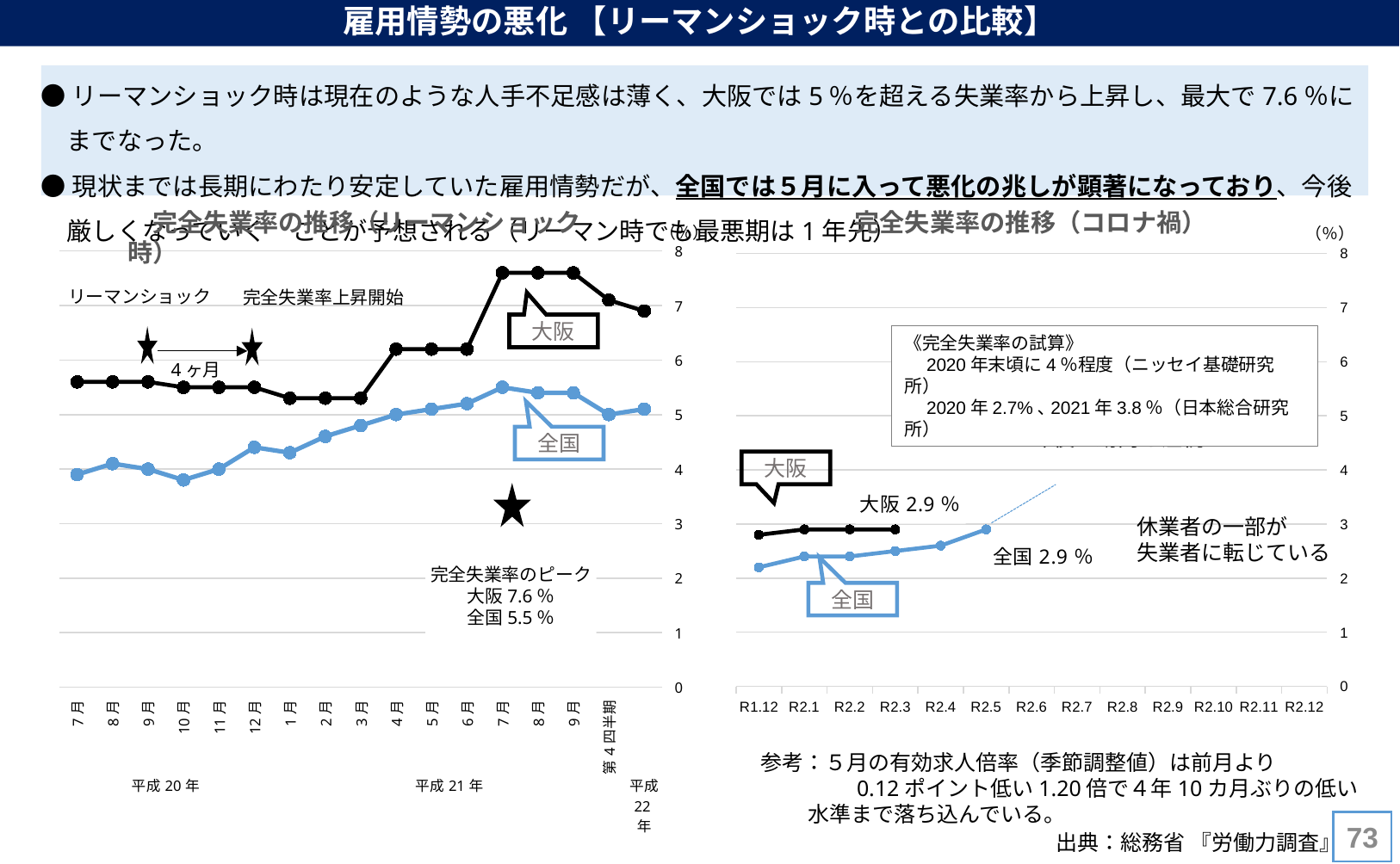
In the left chart (リーマンショック時), how many months elapsed between リーマンショック and 完全失業率上昇開始 according to the annotation? 4ヶ月 In the right chart (コロナ禍), what is the labelled value for 大阪? 2.9％ In the left chart (リーマンショック時), does the 大阪 line rise or fall from 7月 平成20年 to 7月 平成21年? rise In the right chart (コロナ禍), is the 全国 value at R1.12 greater or less than 3? less In the right chart (コロナ禍), what is the labelled value for 全国 at R2.5? 2.9％ In the left chart (リーマンショック時), is the 大阪 value at 7月 平成20年 greater or less than 5? greater In the left chart (リーマンショック時), which line is higher throughout, 大阪 or 全国? 大阪 What kind of chart is the left chart, 完全失業率の推移（リーマンショック時）? line chart In the left chart (リーマンショック時), what was the peak unemployment rate for 大阪? 7.6％ In the left chart (リーマンショック時), how much higher was the 大阪 peak (7.6％) than the 全国 peak (5.5％)? 2.1％ In the right chart (コロナ禍), how many x-axis labels are shown from R1.12 to R2.12? 13 In the left chart (リーマンショック時), what was the peak unemployment rate for 全国? 5.5％